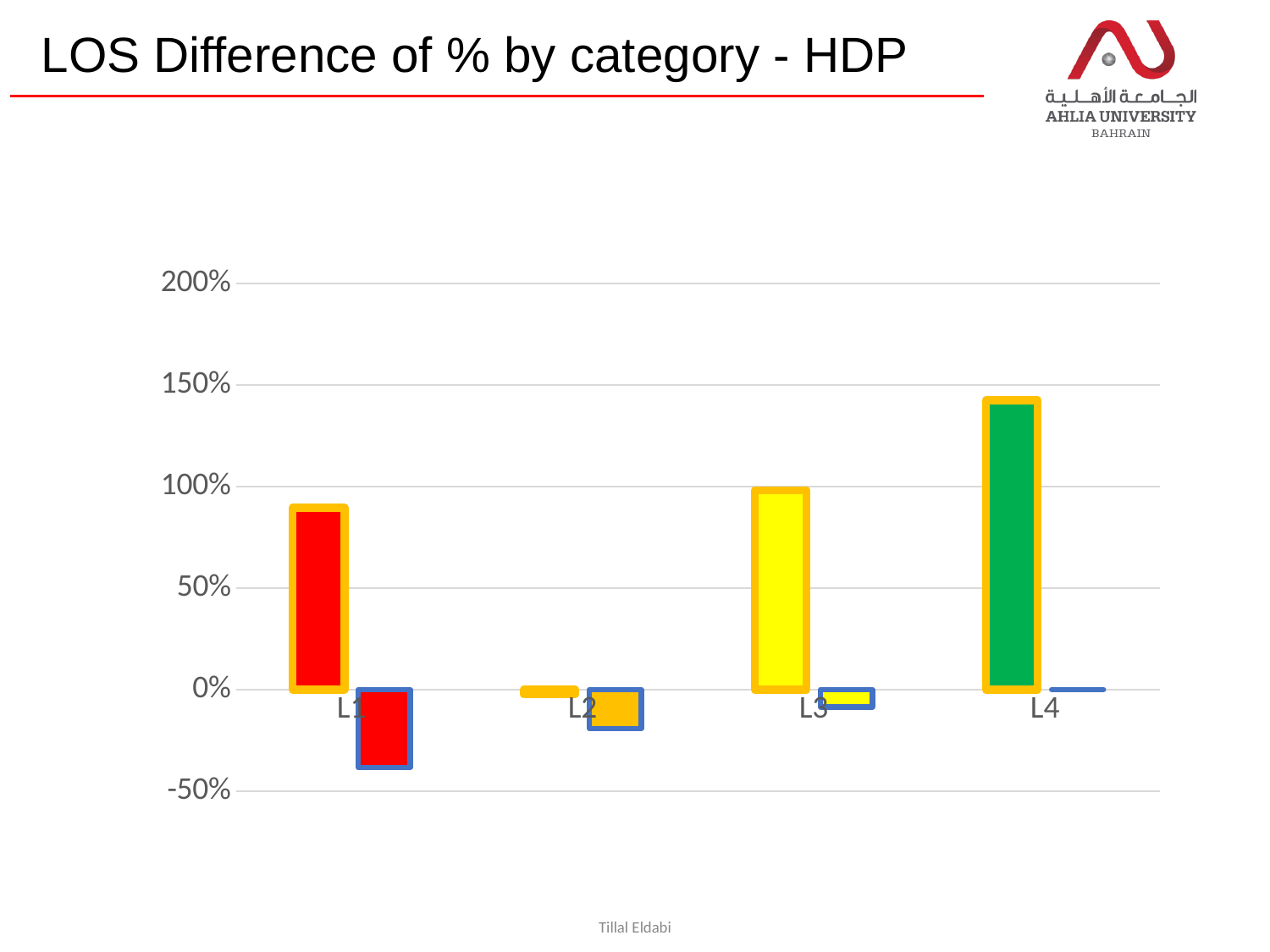
Which has the larger gold-outlined bar, L1 or L4? L4 Which category has the lowest blue-outlined bar? L1 What kind of chart is shown on the slide? bar chart Is the value of the gold-outlined bar for L1 greater or less than 100%? less Is the value of the gold-outlined bar for L4 greater or less than 100%? greater How many bars are plotted for each category in the chart? 2 Which category has the tallest gold-outlined bar? L4 How many categories are shown on the x axis of the chart? 4 Is the value of the gold-outlined bar for L3 greater or less than 50%? greater What is the title of the slide containing the chart? LOS Difference of % by category - HDP Which category's gold-outlined bar falls below 0%? L2